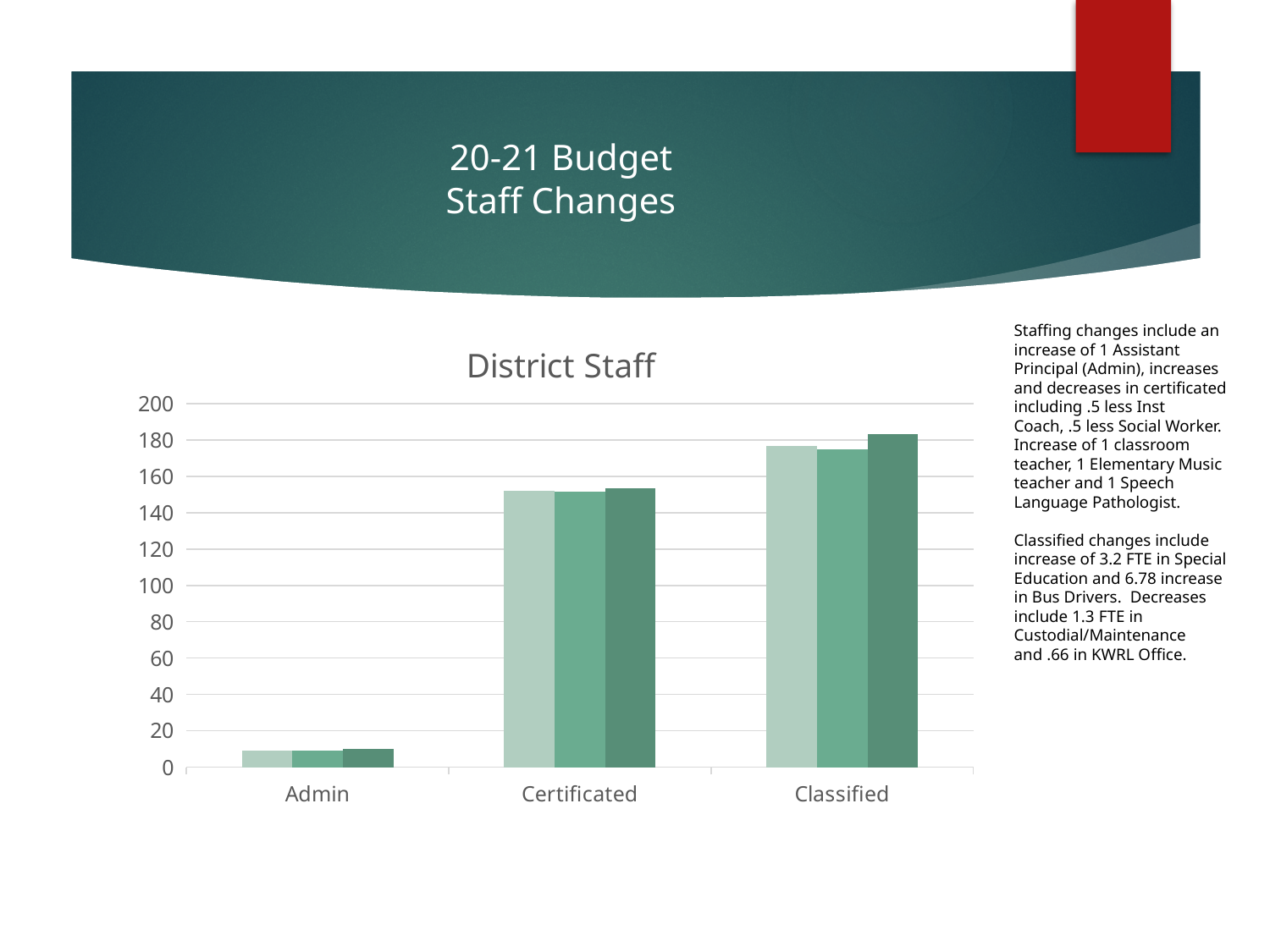
Are the values for Classified greater or less than 160? greater Are the values for Certificated greater or less than 140? greater Which category has the highest values in the District Staff chart? Classified How many categories are shown on the x axis of the District Staff chart? 3 Do the values rise or fall moving from Admin to Classified along the x axis? rise What kind of chart is the District Staff chart? bar chart Which category has larger values, Certificated or Classified? Classified What is the title of the chart on the slide? District Staff Are the values for Classified greater or less than 200? less Which category has the lowest values in the District Staff chart? Admin